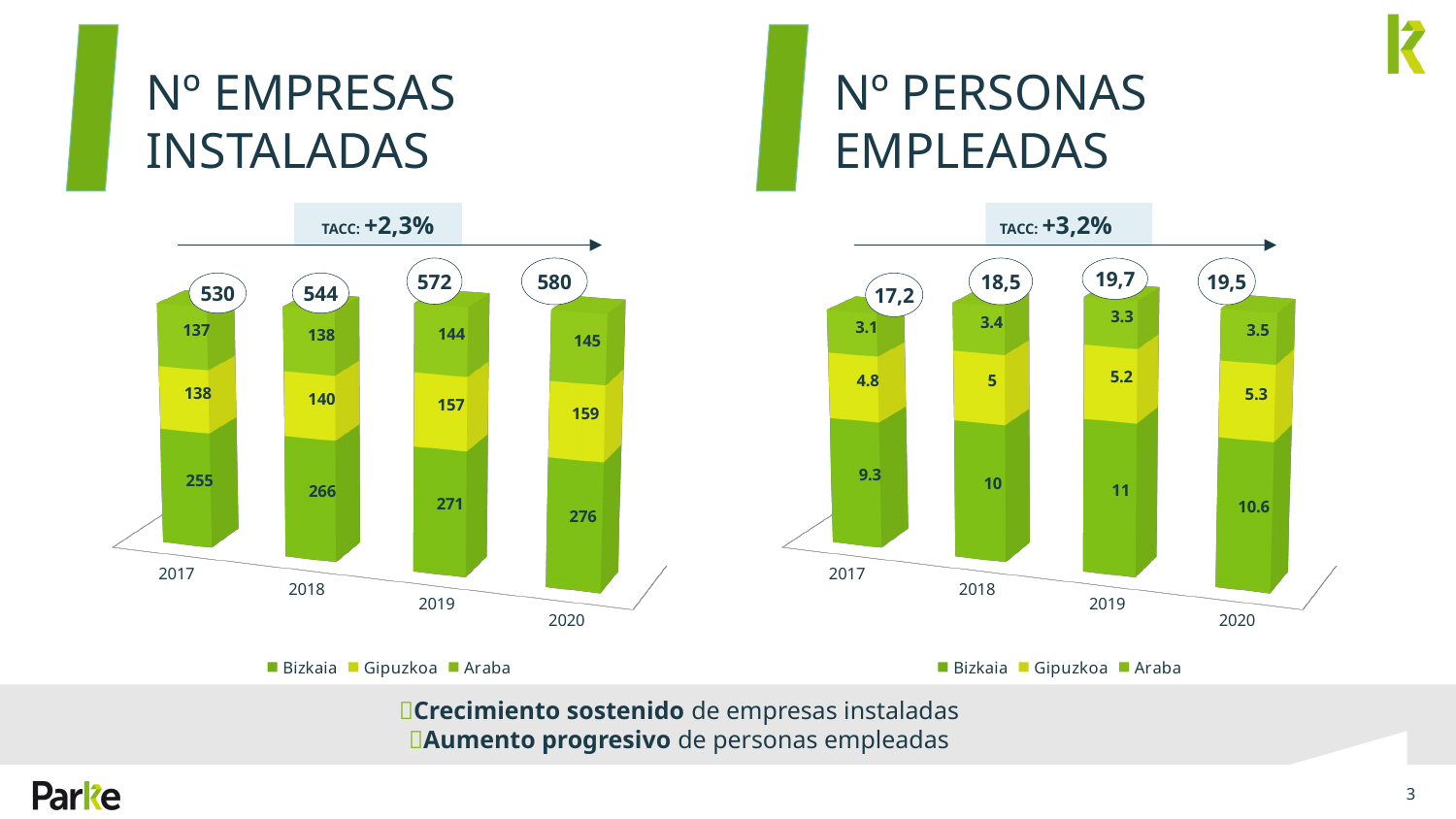
How many series does the legend of the 'Nº PERSONAS EMPLEADAS' chart list? 3 How many years are shown on the x axis of the 'Nº EMPRESAS INSTALADAS' chart? 4 In the 'Nº EMPRESAS INSTALADAS' chart, what is the difference between the Gipuzkoa values for 2019 and 2018? 17 In the 'Nº EMPRESAS INSTALADAS' chart, what is the total shown above the 2019 bar? 572 In the 'Nº PERSONAS EMPLEADAS' chart, which year has the lowest total? 2017 In the 'Nº EMPRESAS INSTALADAS' chart, which year has the highest total? 2020 In the 'Nº PERSONAS EMPLEADAS' chart, is the Bizkaia value larger in 2019 or in 2020? 2019 What kind of chart is the 'Nº EMPRESAS INSTALADAS' chart? stacked bar chart In the 'Nº PERSONAS EMPLEADAS' chart, what is the value for Gipuzkoa in 2017? 4.8 In the 'Nº EMPRESAS INSTALADAS' chart, what is the value for Bizkaia in 2020? 276 In the 'Nº EMPRESAS INSTALADAS' chart, do the totals rise or fall from 2017 to 2020? rise In the 'Nº PERSONAS EMPLEADAS' chart, what is the total shown above the 2019 bar? 19,7